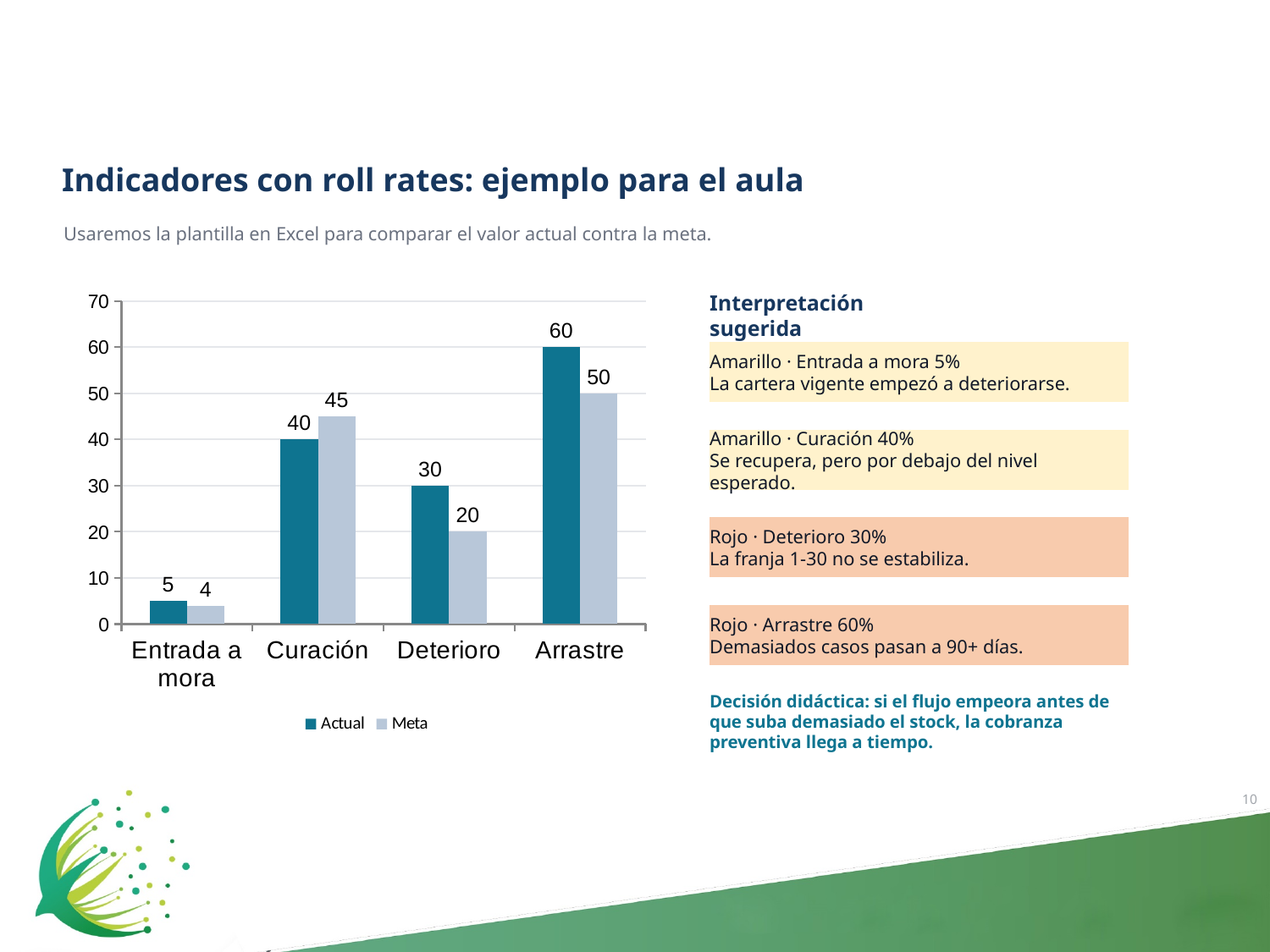
What is the Actual value for Curación? 40 How many series does the legend list? 2 Is the Actual value for Arrastre greater or less than 50? greater What kind of chart is shown on the slide? bar chart How many categories are shown on the x axis? 4 For Curación, which is larger, the Actual value or the Meta value? Meta Which category has the highest Actual value? Arrastre What is the difference between the Actual and Meta values for Deterioro? 10 What are the two series named in the legend? Actual and Meta Which category has the lowest Meta value? Entrada a mora What is the Meta value for Entrada a mora? 4 What is the Meta value for Arrastre? 50